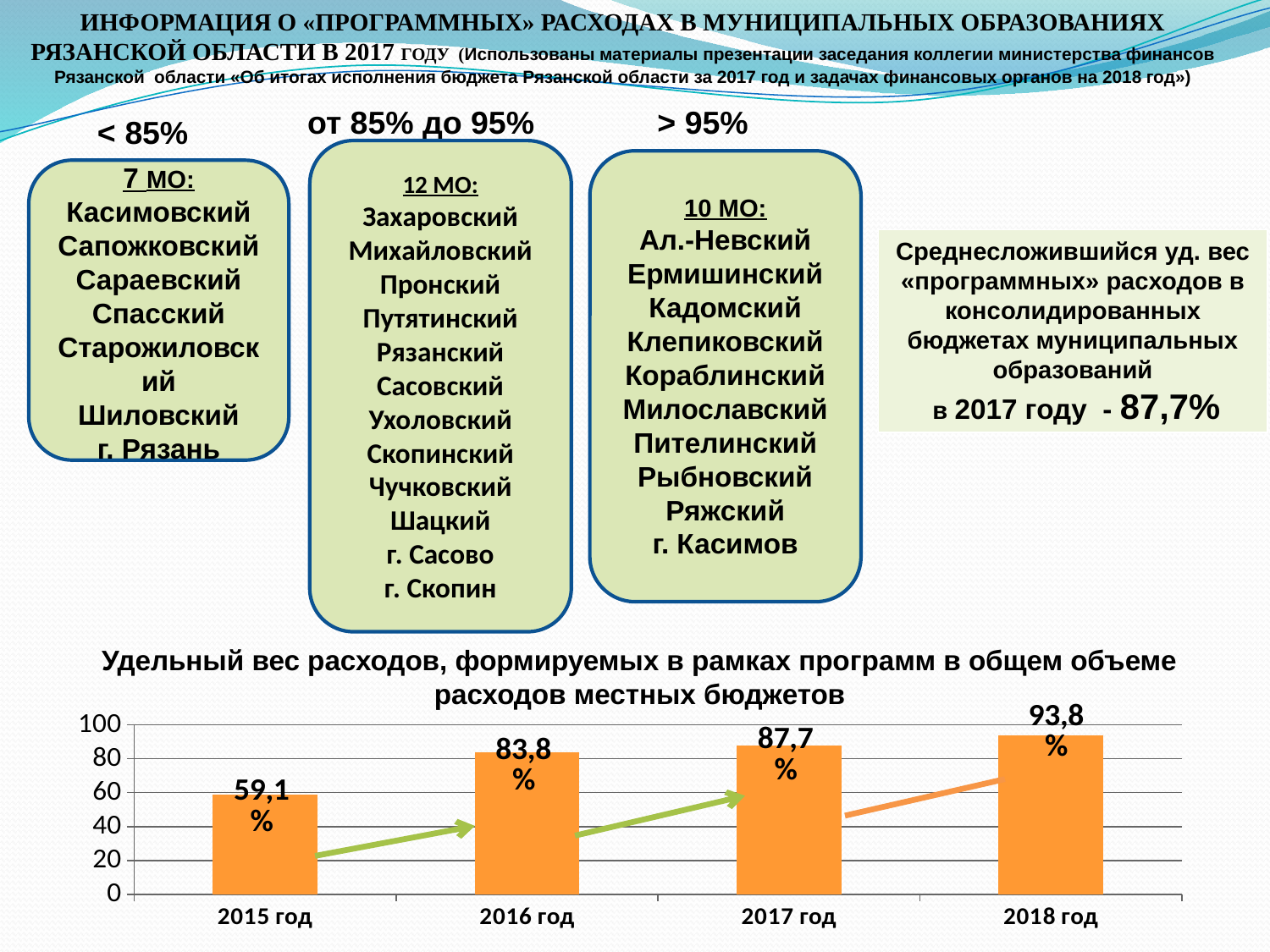
What is the value shown for 2015 год in the chart? 59,1% What is the difference between the values for 2018 год and 2015 год? 34,7% How many years (categories) are shown on the x axis of the chart? 4 What is the value shown for 2018 год in the chart? 93,8% Which is larger, the value for 2016 год or the value for 2017 год? 2017 год What is the difference between the values for 2017 год and 2016 год? 3,9% Which year has the lowest value in the chart? 2015 год What is the value shown for 2017 год in the chart? 87,7% What kind of chart is shown at the bottom of the slide? Bar chart Do the values rise or fall from 2015 год to 2018 год? Rise Which year has the highest value in the chart? 2018 год What is the value shown for 2016 год in the chart? 83,8%